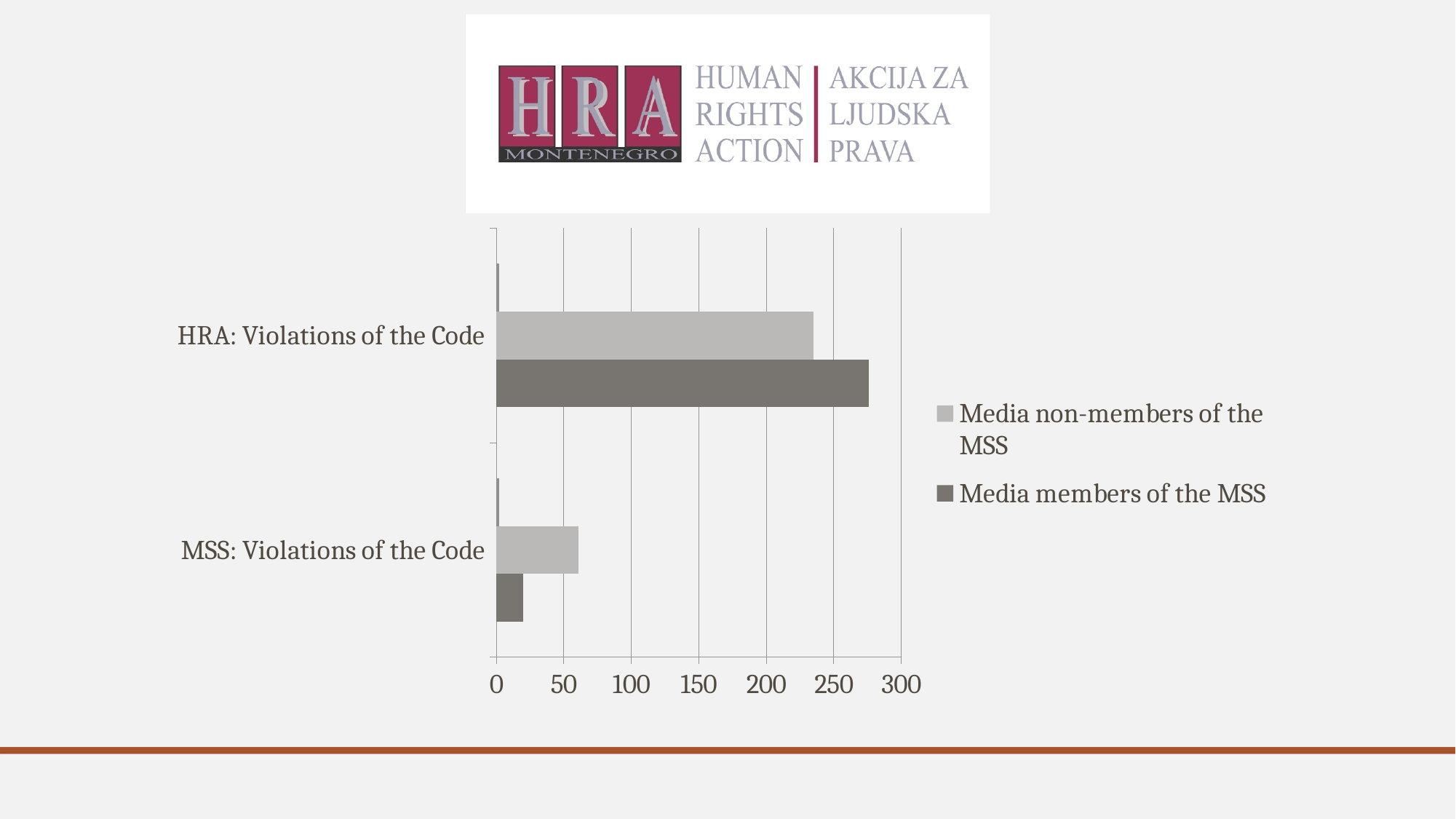
Which category has the lower value for Media non-members of the MSS? MSS: Violations of the Code For MSS: Violations of the Code, which series has the larger value, Media non-members of the MSS or Media members of the MSS? Media non-members of the MSS What is the highest value labelled on the chart's horizontal axis? 300 For HRA: Violations of the Code, which series has the larger value, Media non-members of the MSS or Media members of the MSS? Media members of the MSS Is the value for Media members of the MSS in HRA: Violations of the Code greater or less than 250? greater Which category has the higher value for Media members of the MSS? HRA: Violations of the Code What kind of chart is shown on the slide? Bar chart Which series is drawn in the darker grey colour? Media members of the MSS Is the value for Media non-members of the MSS in HRA: Violations of the Code greater or less than 250? less Is the value for Media members of the MSS in MSS: Violations of the Code greater or less than 50? less How many categories are shown on the chart's vertical axis? 2 How many series does the chart's legend list? 2